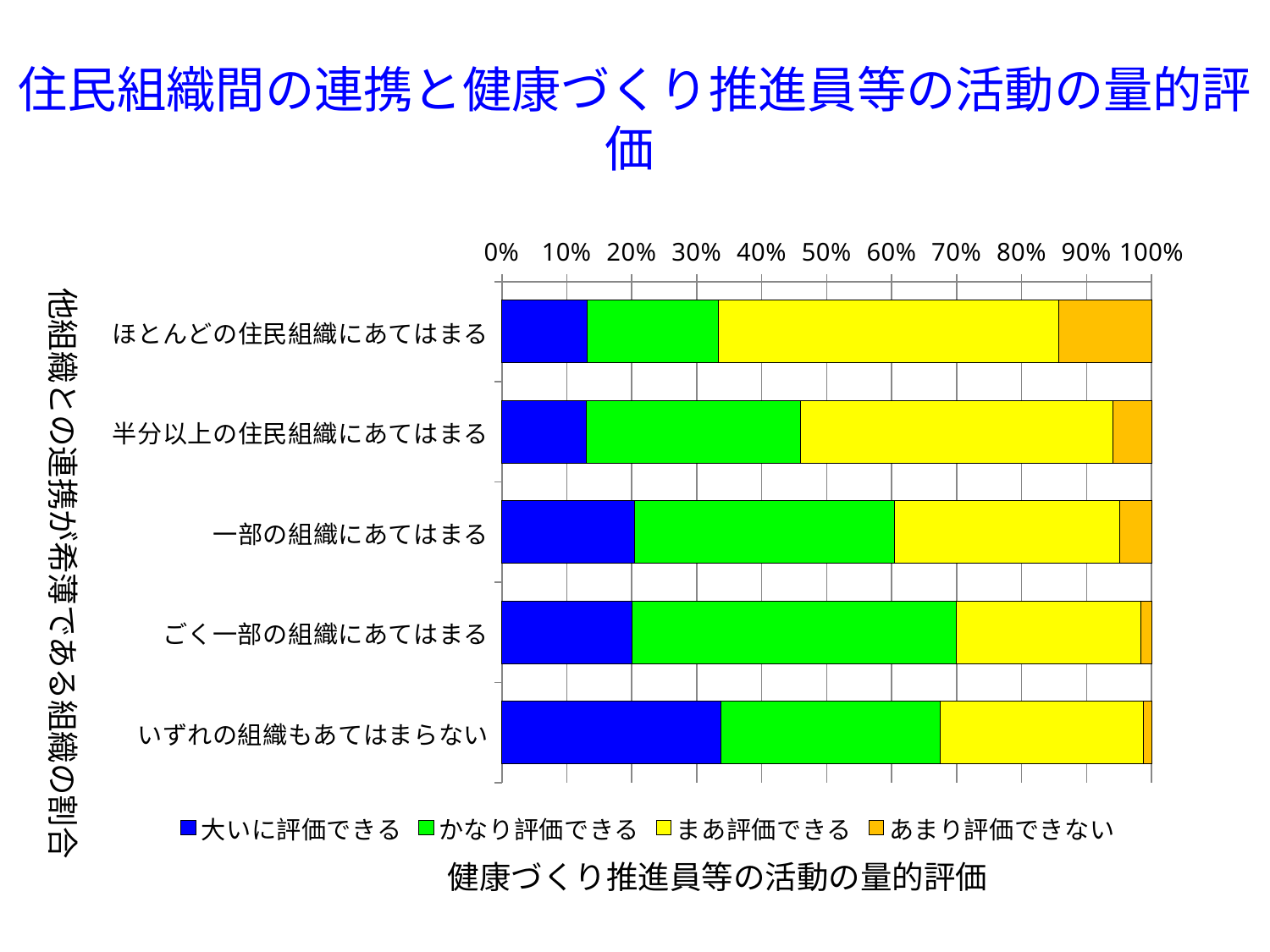
Is the 大いに評価できる share for いずれの組織もあてはまらない greater or less than 30%? greater What kind of chart is shown on the slide? Stacked bar chart Which category has the largest あまり評価できない segment? ほとんどの住民組織にあてはまる Which has the larger あまり評価できない segment: ほとんどの住民組織にあてはまる or ごく一部の組織にあてはまる? ほとんどの住民組織にあてはまる Which has the larger 大いに評価できる segment: 一部の組織にあてはまる or ほとんどの住民組織にあてはまる? 一部の組織にあてはまる What colour represents 大いに評価できる in the legend? Blue Is the 大いに評価できる share for 一部の組織にあてはまる greater or less than 10%? greater How many series does the chart's legend list? 4 How many categories are plotted on the vertical axis of the chart? 5 Is the 大いに評価できる share for ほとんどの住民組織にあてはまる greater or less than 20%? less Which category has the largest 大いに評価できる segment? いずれの組織もあてはまらない What is the title shown below the chart's horizontal axis? 健康づくり推進員等の活動の量的評価